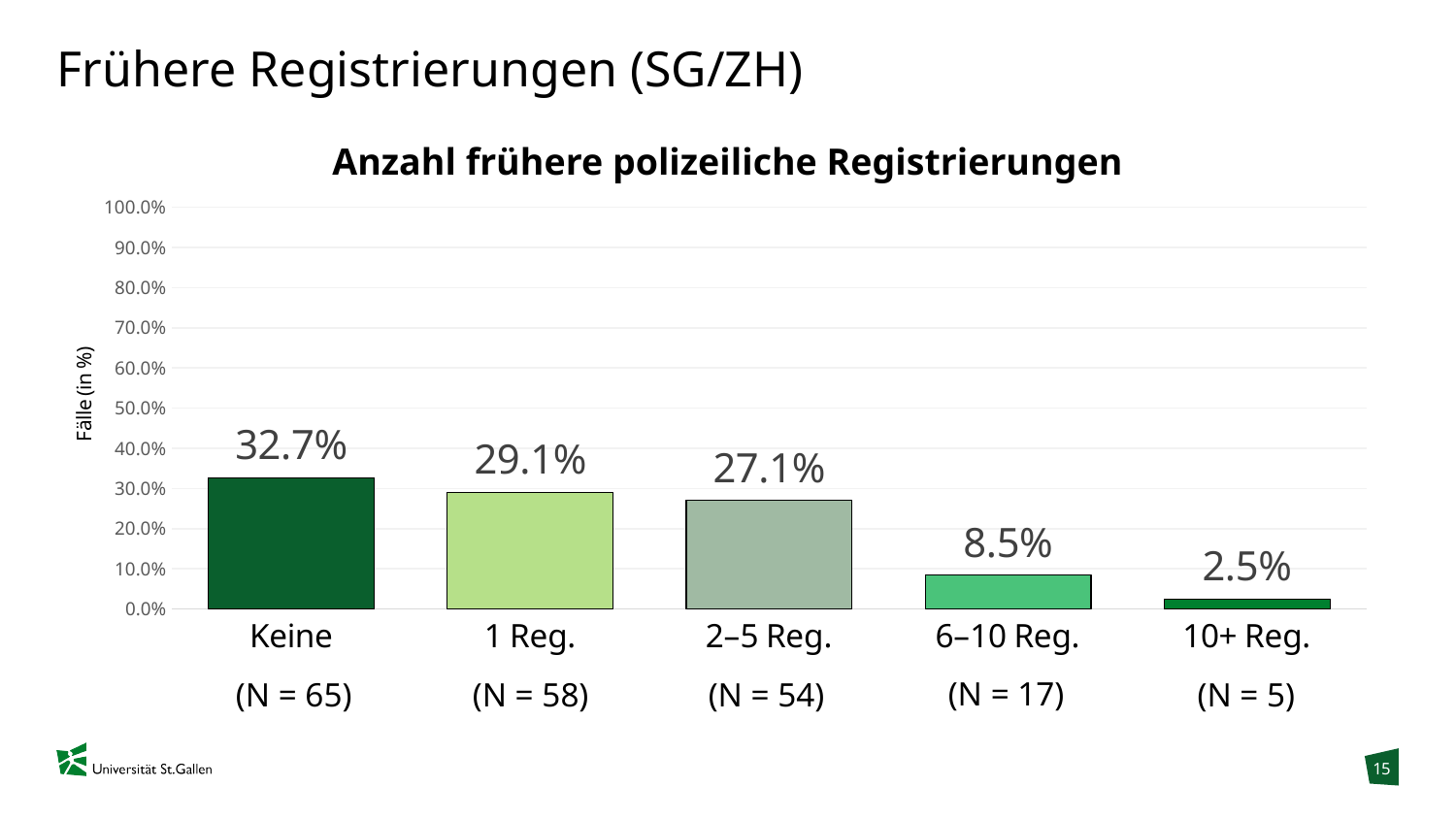
Which category has the highest value? Keine What kind of chart is shown? bar chart What is the difference between the values for "Keine" and "1 Reg."? 3.6% Which is larger, the value for "1 Reg." or the value for "2–5 Reg."? 1 Reg. What is the value for "Keine"? 32.7% What is the value for "6–10 Reg."? 8.5% Is the value for "Keine" greater or less than 30.0%? greater How many categories are shown on the x axis? 5 Which category has the lowest value? 10+ Reg. What is the title of the chart? Anzahl frühere polizeiliche Registrierungen What is the difference between the values for "2–5 Reg." and "6–10 Reg."? 18.6% What is the value for "10+ Reg."? 2.5%